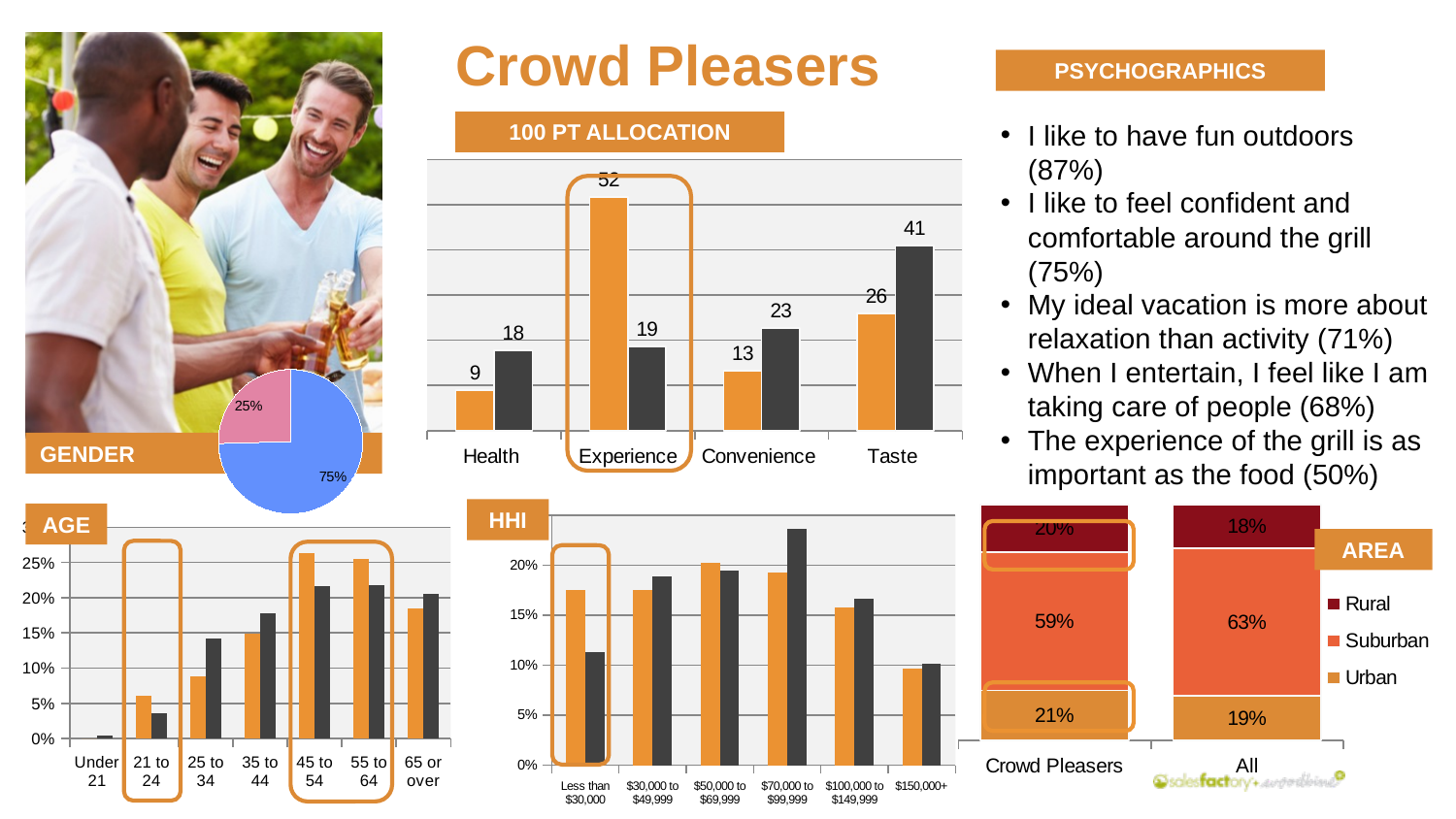
In the 100 PT ALLOCATION chart, how many categories are shown on the x axis? 4 In the 100 PT ALLOCATION chart, what is the value of the orange bar for Experience? 52 In the HHI chart, is the dark bar for Less than $30,000 greater or less than 15%? less In the GENDER pie chart, what share does the larger slice represent? 75% In the AREA chart, how many series does the legend list? 3 In the 100 PT ALLOCATION chart, which category has the highest orange bar? Experience In the 100 PT ALLOCATION chart, which category has the lowest orange bar? Health In the AREA chart, what is the Suburban percentage for Crowd Pleasers? 59% In the AREA chart, what is the Rural percentage for All? 18% In the AGE chart, is the orange bar for 45 to 54 greater or less than 25%? greater In the 100 PT ALLOCATION chart, what is the value of the dark bar for Taste? 41 In the 100 PT ALLOCATION chart, what is the difference between the orange and dark bars for Experience? 33